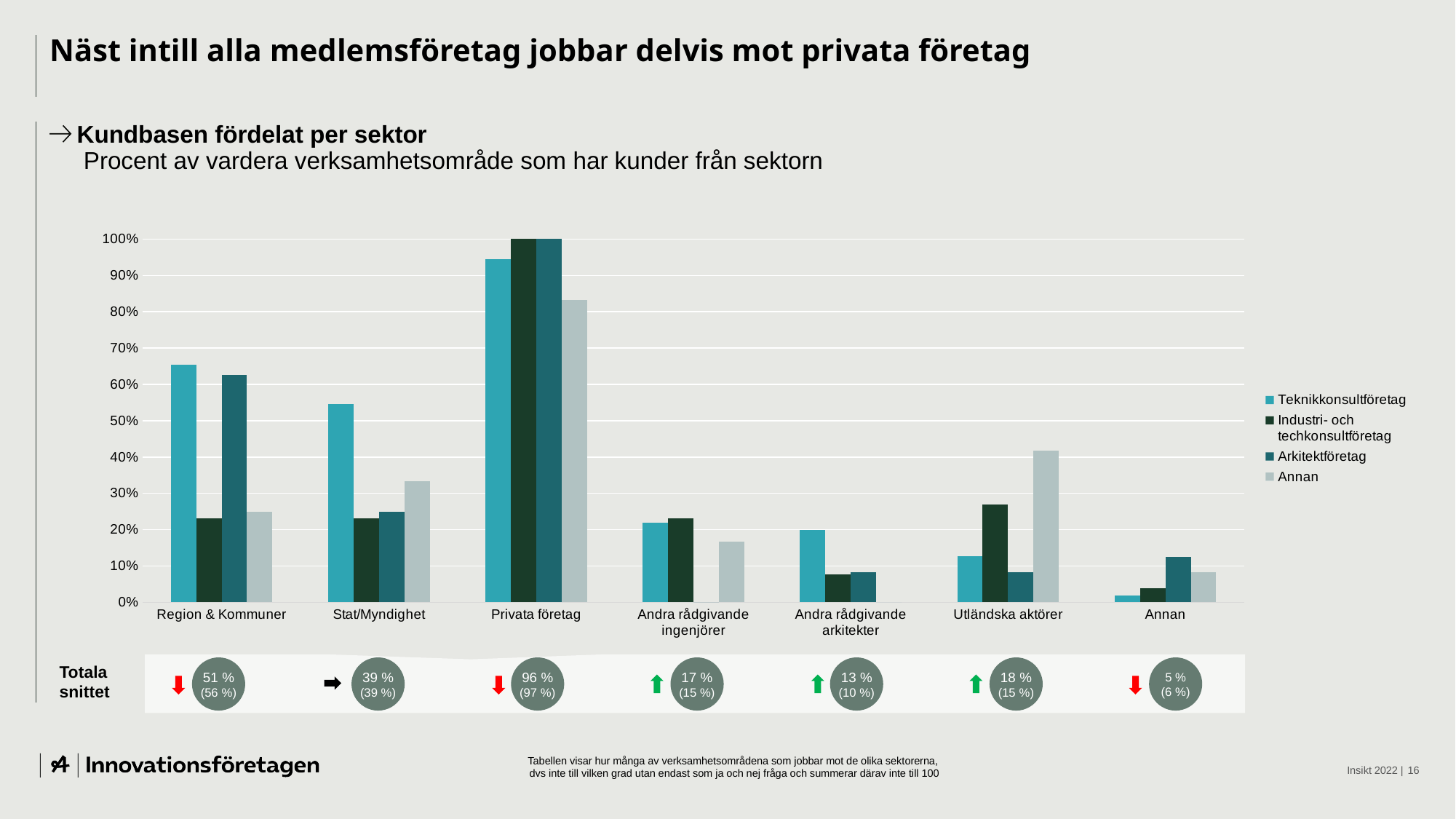
Which sector has the lowest value for Teknikkonsultföretag? Annan What is the value for Arkitektföretag in Privata företag? 100% How many sector categories are shown on the x axis? 7 What is the Totala snittet value shown for Privata företag? 96 % In Region & Kommuner, which is larger: Teknikkonsultföretag or Industri- och techkonsultföretag? Teknikkonsultföretag Which sector has the highest values across the series? Privata företag Which series is shown in the lightest grey colour in the legend? Annan How many series does the legend list? 4 What kind of chart is shown on the slide? bar chart Is the value for Teknikkonsultföretag in Region & Kommuner greater or less than 60%? greater Is the value for Annan in Utländska aktörer greater or less than 30%? greater What is the value for Industri- och techkonsultföretag in Privata företag? 100%